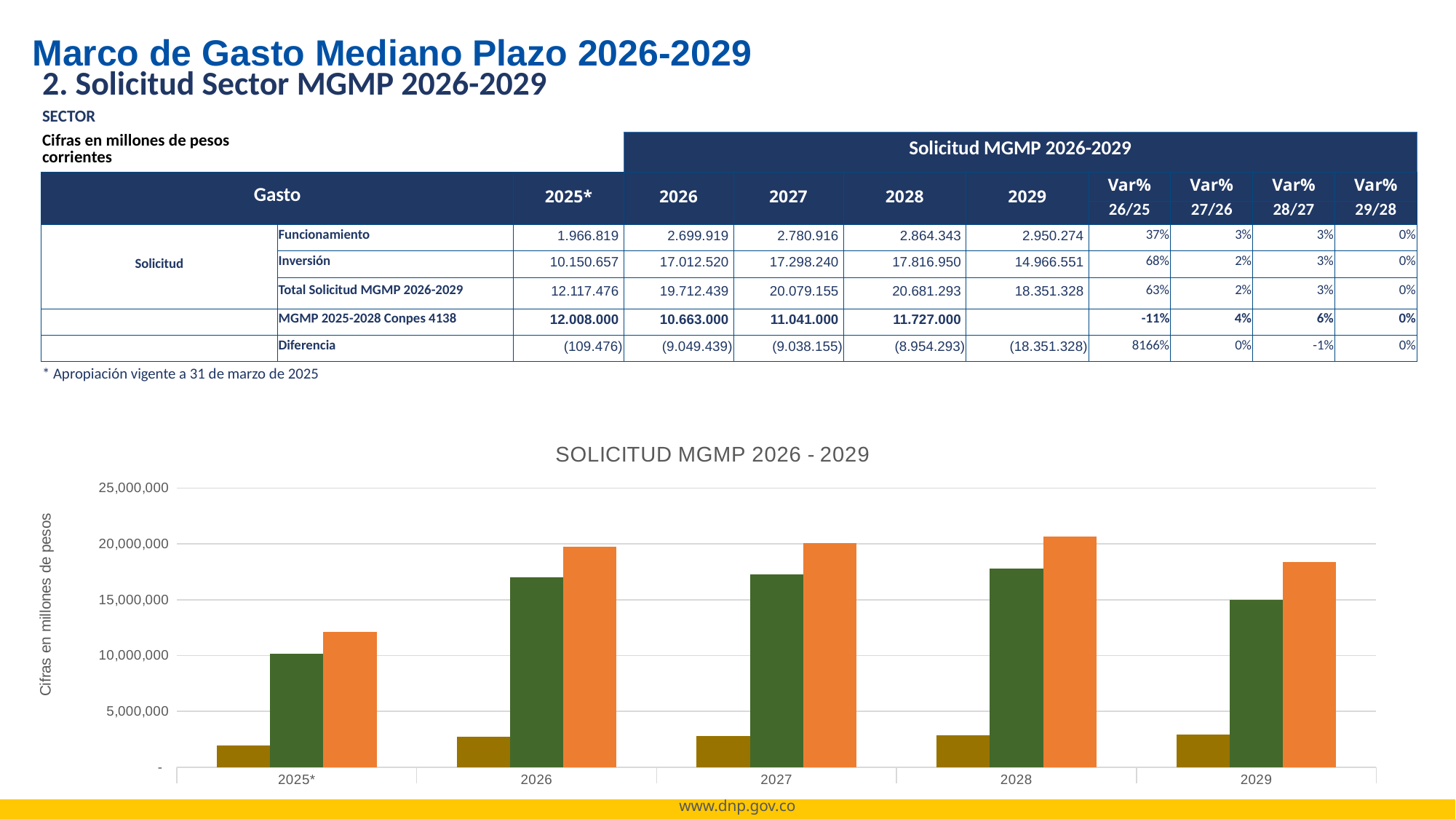
Is the orange bar for 2029 greater or less than 20,000,000? less Which is larger, the green bar for 2025* or the green bar for 2026? 2026 In which year is the green bar the lowest? 2025* What is the title of the chart? SOLICITUD MGMP 2026 - 2029 How many year categories are shown on the x axis of the chart? 5 What is the label on the vertical axis of the chart? Cifras en millones de pesos In which year is the orange bar the lowest? 2025* Is the orange bar for 2025* greater or less than 15,000,000? less What kind of chart is shown on the slide? bar chart How many bars are plotted for each year category in the chart? 3 Is the green bar for 2029 greater or less than 10,000,000? greater